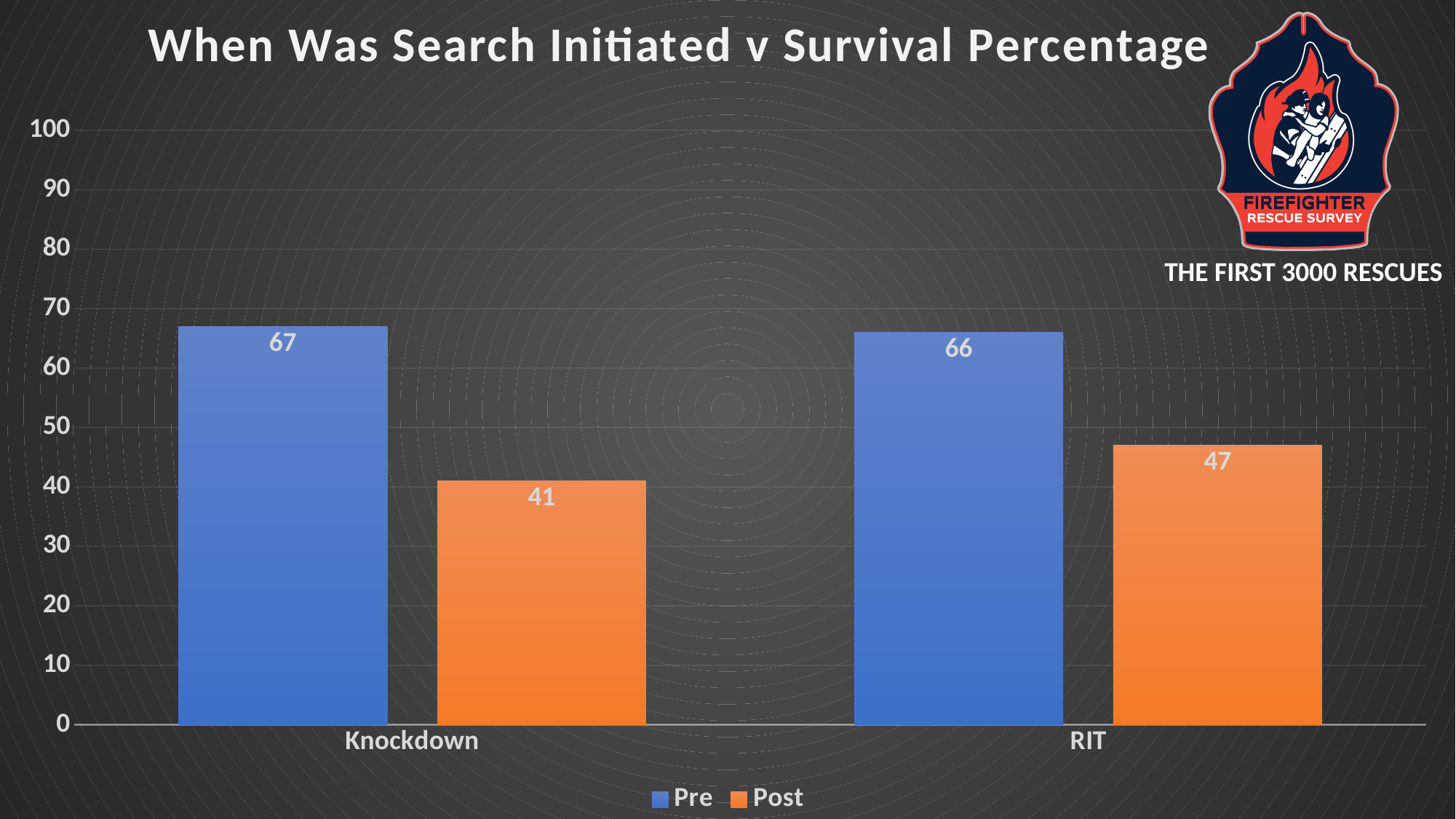
Which bar has the lowest value on the chart? Post for Knockdown Is the Post value for RIT greater or less than 50? less How many series does the legend list? 2 What kind of chart is shown on the slide? Bar chart How many categories are shown on the x axis? 2 What is the difference between the Pre and Post values for RIT? 19 What is the Post value for Knockdown? 41 Which is larger, the Post value for Knockdown or the Post value for RIT? Post value for RIT What is the Pre value for Knockdown? 67 What is the Post value for RIT? 47 What is the Pre value for RIT? 66 What is the difference between the Pre and Post values for Knockdown? 26